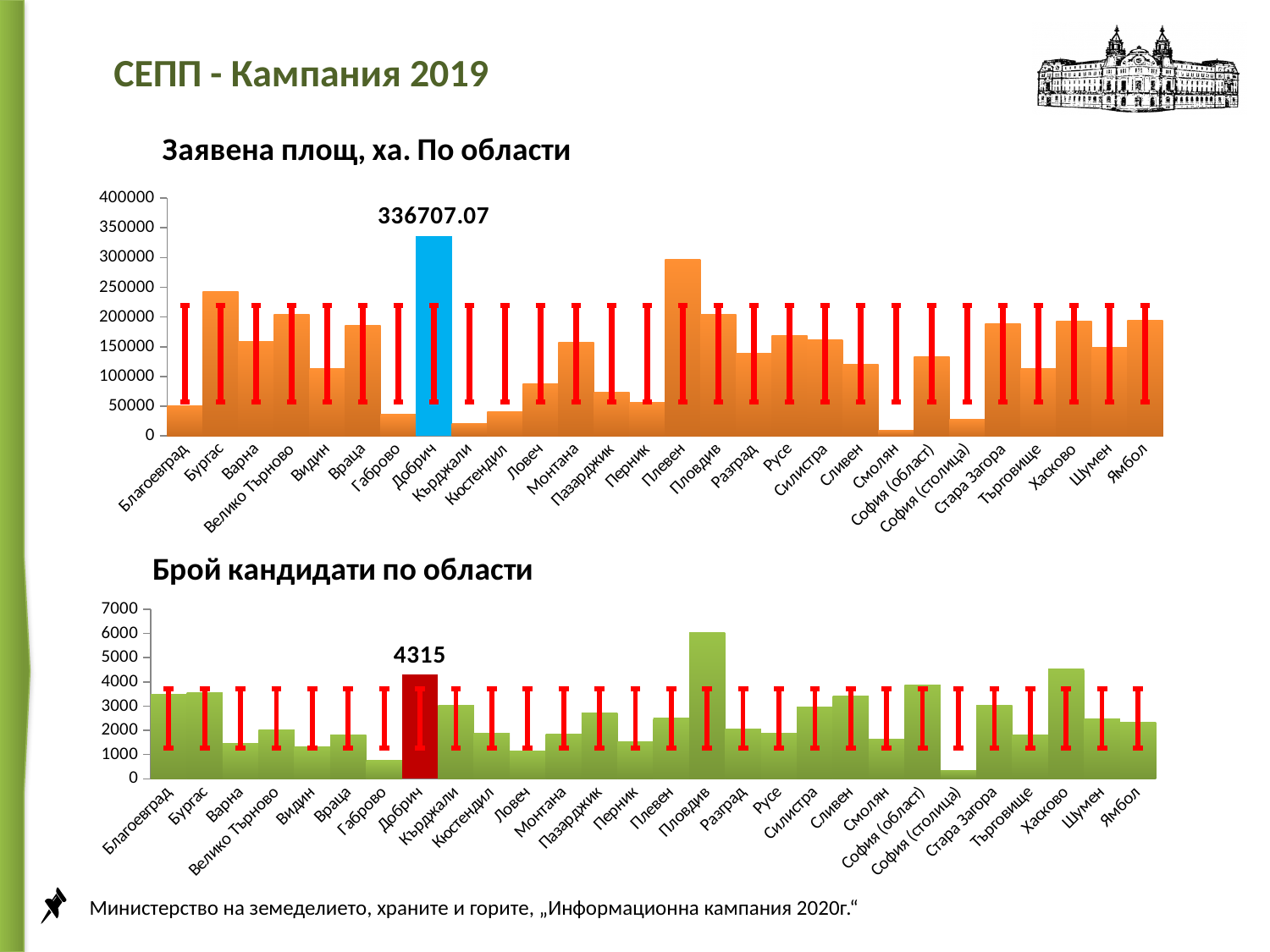
In the chart titled "Брой кандидати по области", what is the value for Добрич? 4315 What kind of chart is the chart titled "Заявена площ, ха. По области"? bar chart In the chart titled "Брой кандидати по области", which region has the lowest value? София (столица) In the chart titled "Брой кандидати по области", which region has the highest value? Пловдив In the chart titled "Заявена площ, ха. По области", which region has the lowest value? Смолян In the chart titled "Заявена площ, ха. По области", which region has the highest value? Добрич How many regions are shown on the x axis of the chart titled "Брой кандидати по области"? 28 In the chart titled "Заявена площ, ха. По области", is the value for Габрово greater or less than 50000? less In the chart titled "Заявена площ, ха. По области", is the value for Плевен greater or less than 250000? greater In the chart titled "Заявена площ, ха. По области", what is the value for Добрич? 336707.07 In the chart titled "Брой кандидати по области", is the value for Пловдив greater or less than 5000? greater In the chart titled "Брой кандидати по области", which is larger, the value for Пловдив or the value for Добрич? Пловдив